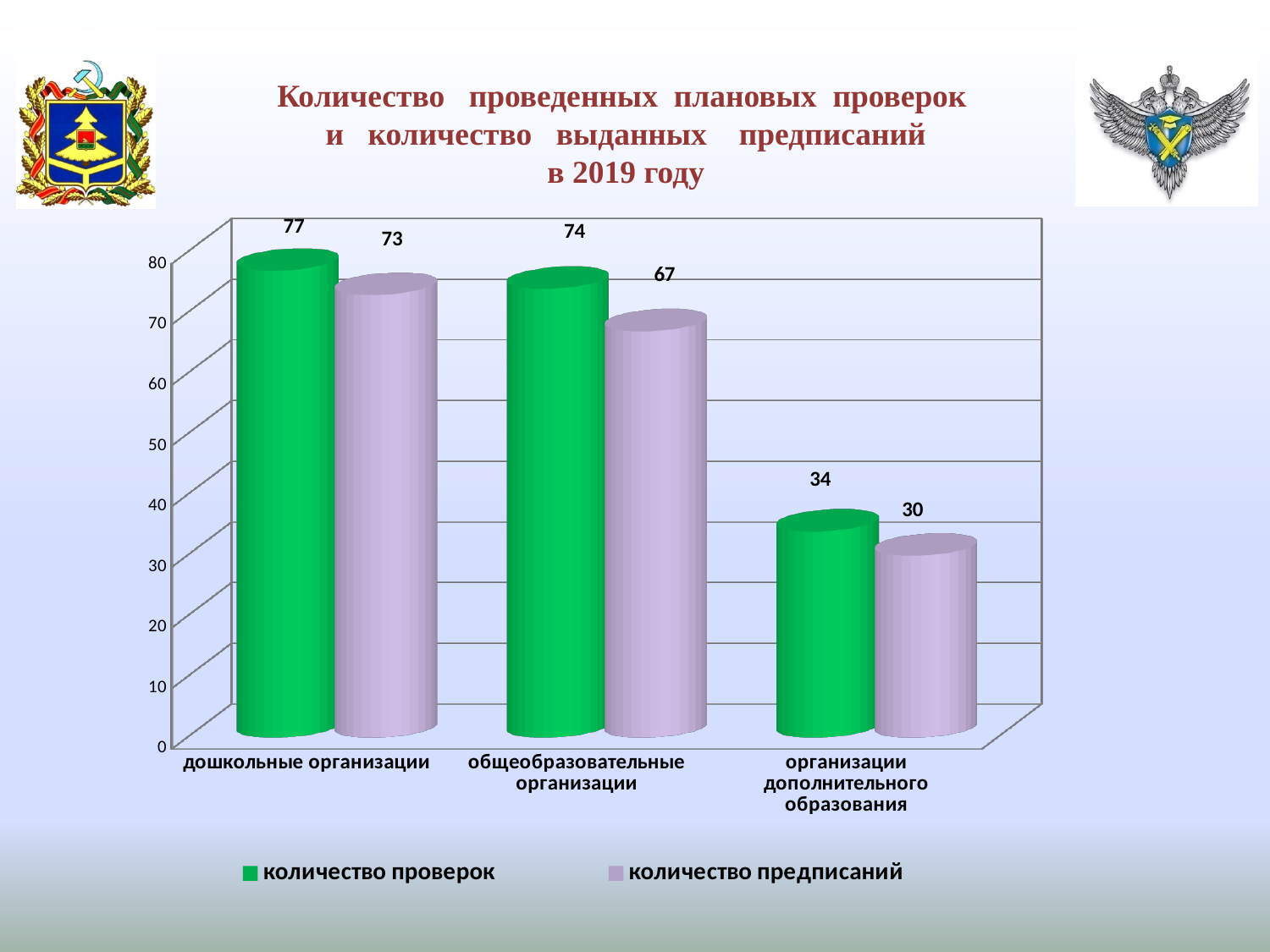
What kind of chart is shown on the slide? bar chart What is the difference in the number of inspections between дошкольные организации and организации дополнительного образования? 43 Which category has the highest number of inspections (количество проверок)? дошкольные организации How many series does the legend list? 2 How many categories are shown on the x axis? 3 Which is larger: the number of orders issued for дошкольные организации or for общеобразовательные организации? дошкольные организации Which category has the lowest number of orders issued (количество предписаний)? организации дополнительного образования What is the number of orders issued (количество предписаний) for общеобразовательные организации? 67 What is the difference between the number of inspections and the number of orders issued for общеобразовательные организации? 7 What is the number of inspections (количество проверок) for дошкольные организации? 77 Which colour represents количество предписаний in the legend? purple (lilac) What is the number of inspections (количество проверок) for организации дополнительного образования? 34